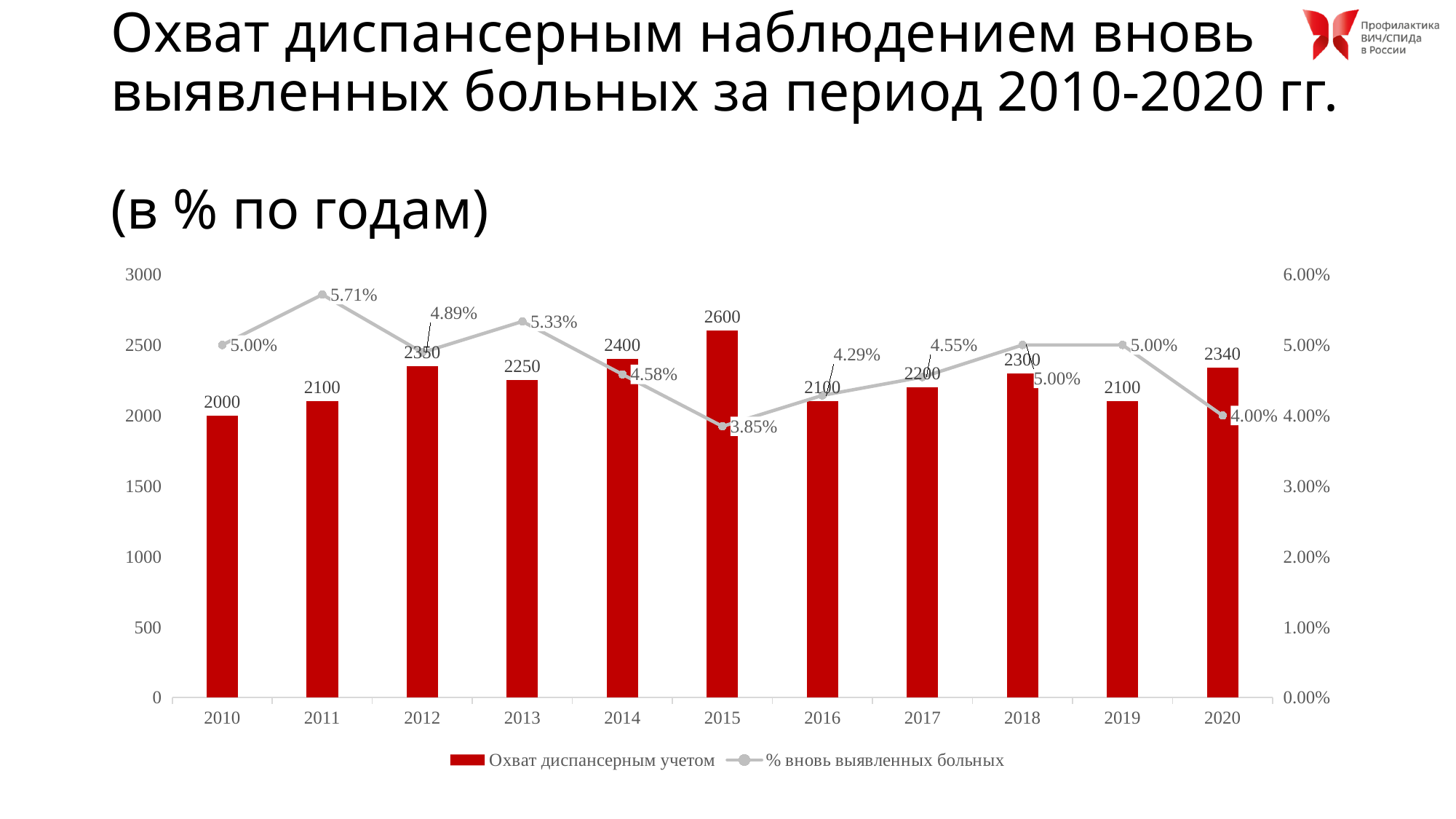
Which year has the lowest value of "Охват диспансерным учетом"? 2010 What is the value of "Охват диспансерным учетом" for 2015? 2600 What is the value of "% вновь выявленных больных" for 2011? 5.71% What is the value of "% вновь выявленных больных" for 2016? 4.29% Which year has the lowest value of "% вновь выявленных больных"? 2015 What colour are the bars for "Охват диспансерным учетом"? Red How many series does the legend list? 2 How many years are shown on the x axis? 11 Which is larger: the "Охват диспансерным учетом" value for 2012 or for 2013? 2012 Which year has the highest value of "Охват диспансерным учетом"? 2015 What is the difference between the "Охват диспансерным учетом" values for 2015 and 2010? 600 What is the value of "Охват диспансерным учетом" for 2020? 2340